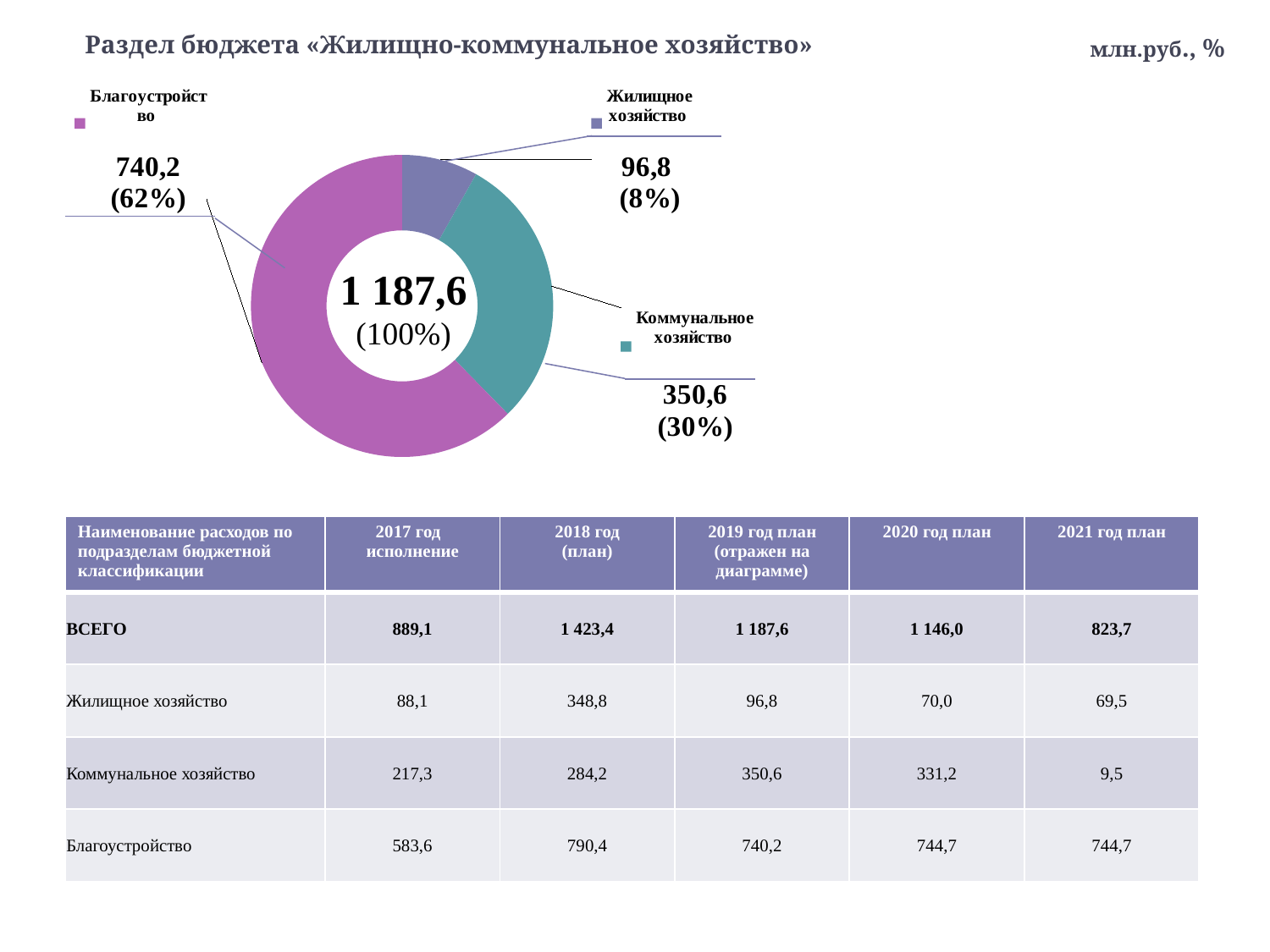
What share of the chart does Благоустройство represent? 62% What type of chart is shown on the slide? Donut (pie) chart Which category has the largest slice in the chart? Благоустройство What share of the chart does Коммунальное хозяйство represent? 30% How many categories are shown in the chart? 3 What total value is shown in the centre of the chart? 1 187,6 What is the difference between the values for Благоустройство and Коммунальное хозяйство on the chart? 389,6 What is the value shown for Благоустройство on the chart? 740,2 What is the value shown for Коммунальное хозяйство on the chart? 350,6 Which category has the smallest slice in the chart? Жилищное хозяйство What share of the chart does Жилищное хозяйство represent? 8% What is the value shown for Жилищное хозяйство on the chart? 96,8